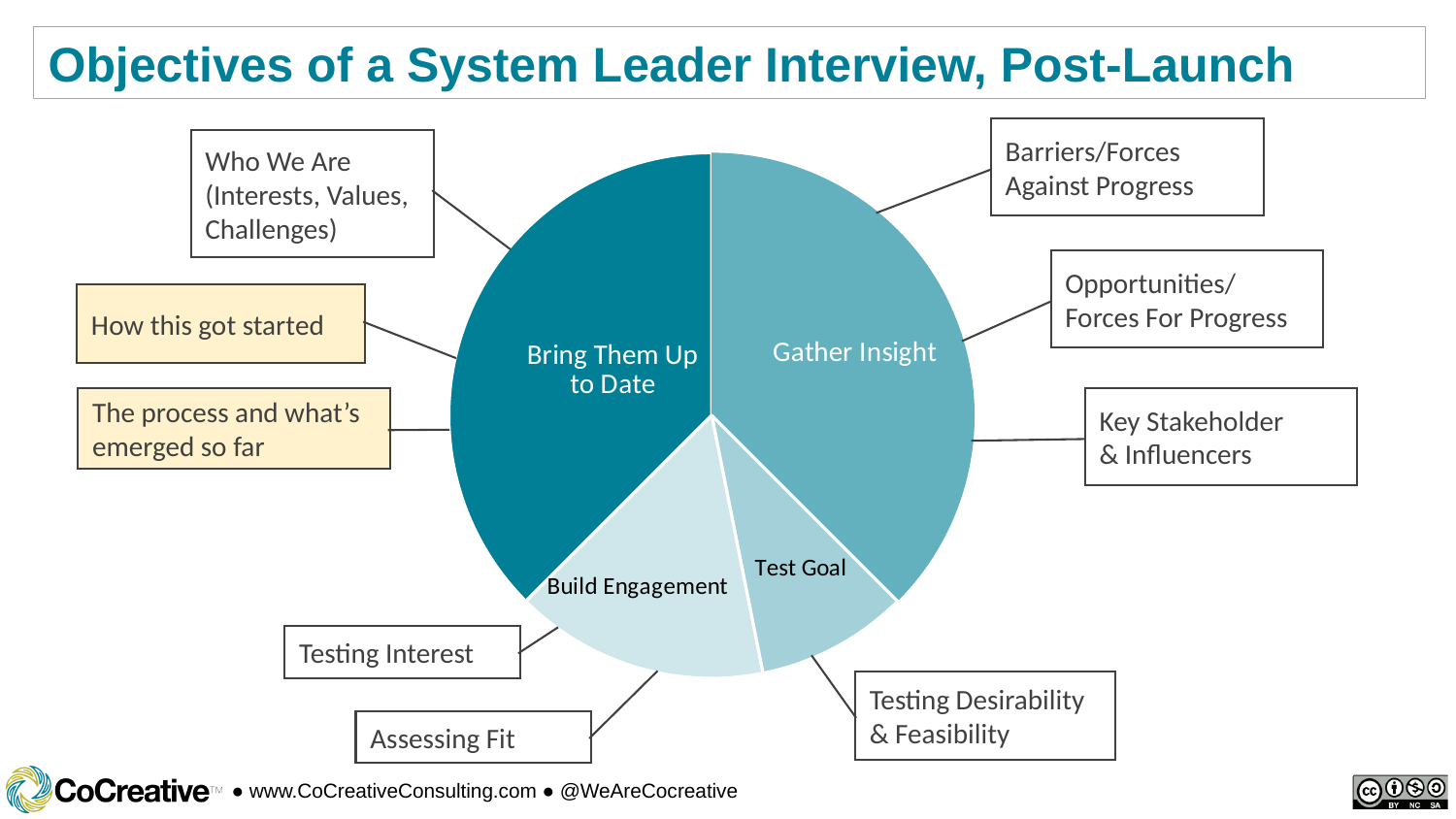
What is the title of the slide containing the pie chart? Objectives of a System Leader Interview, Post-Launch Which slice is larger, Gather Insight or Build Engagement? Gather Insight Which slice is larger, Bring Them Up to Date or Build Engagement? Bring Them Up to Date What kind of chart is shown on the slide? pie chart How many slices does the pie chart have? 4 Which slice is larger, Build Engagement or Test Goal? Build Engagement Which slice of the pie chart is the smallest? Test Goal Which slice of the pie chart is annotated with the callout "Testing Desirability & Feasibility"? Test Goal